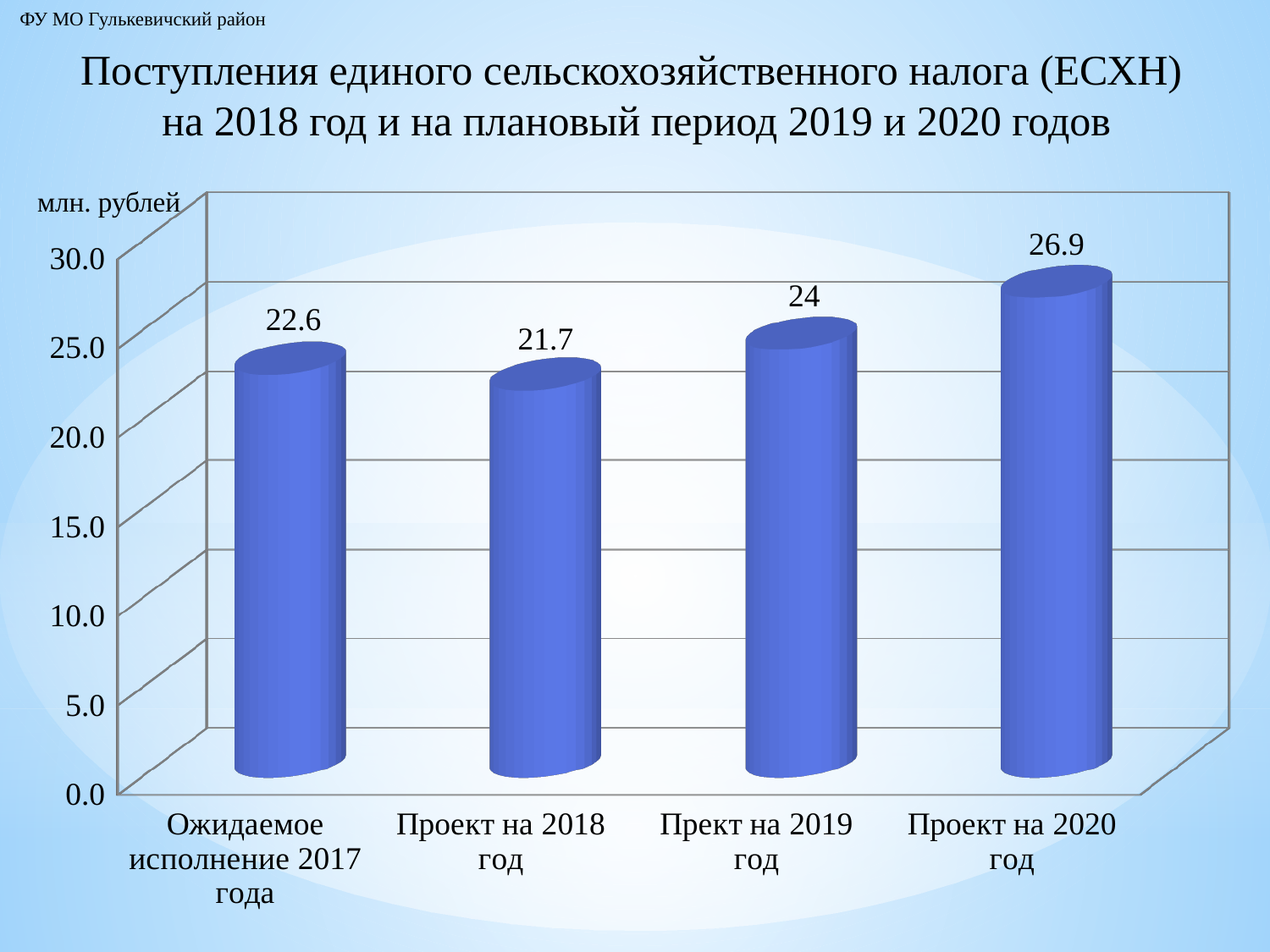
Which category has the highest value? Проект на 2020 год What is the value for "Проект на 2018 год"? 21.7 Which is larger: the value for "Ожидаемое исполнение 2017 года" or the value for "Прект на 2019 год"? Прект на 2019 год What is the value for "Прект на 2019 год"? 24 What kind of chart is shown on the slide? bar chart What is the value for "Ожидаемое исполнение 2017 года"? 22.6 What is the value for "Проект на 2020 год"? 26.9 What unit is shown on the chart's vertical axis? млн. рублей Which category has the lowest value? Проект на 2018 год What is the difference between the values for "Проект на 2020 год" and "Проект на 2018 год"? 5.2 Is the value for "Проект на 2020 год" greater or less than 25.0? greater How many categories are shown on the chart? 4